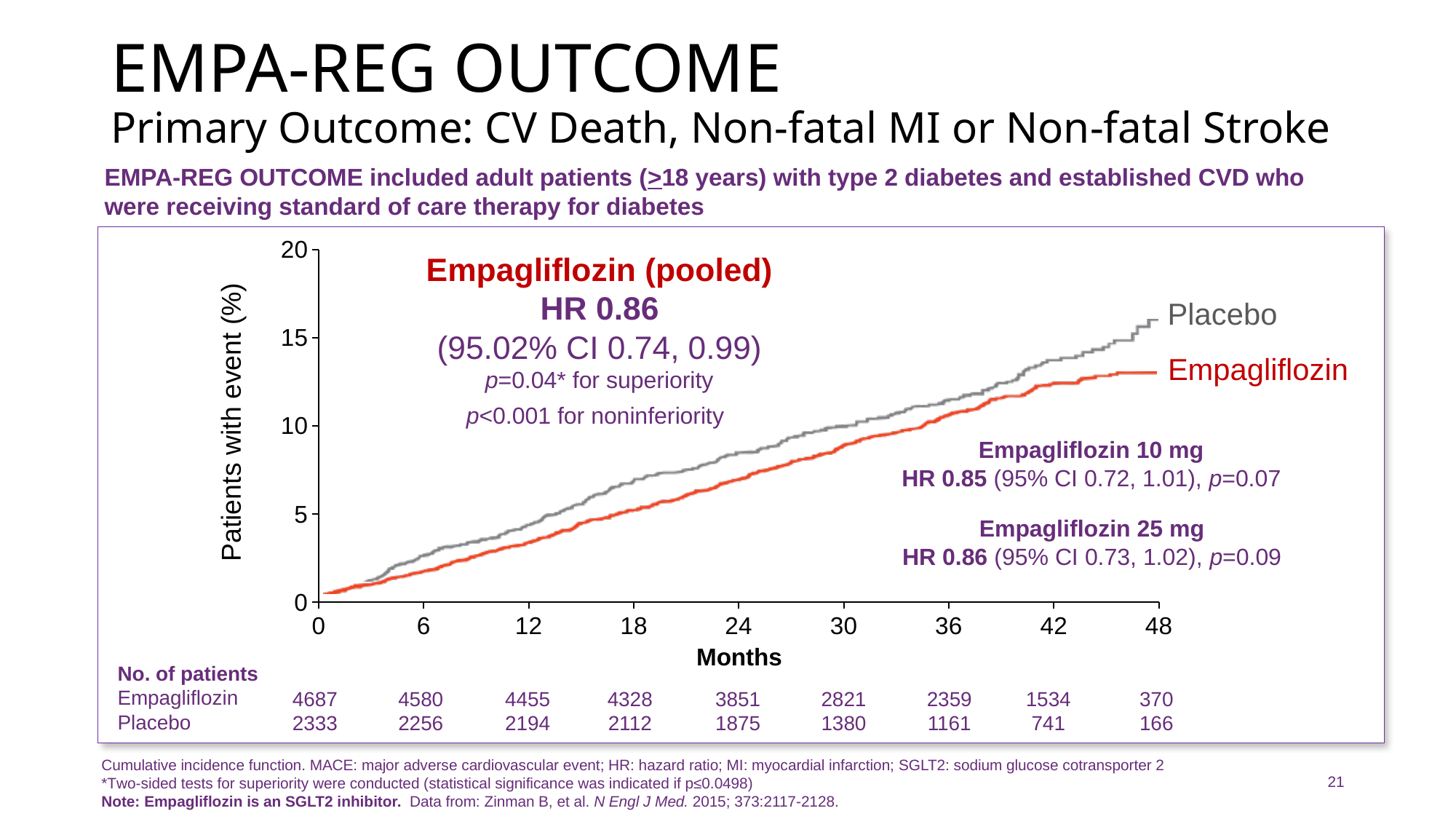
According to the No. of patients table, how many Empagliflozin patients were there at month 0? 4687 According to the No. of patients table, what is the difference between the number of Empagliflozin and Placebo patients at month 24? 1976 According to the No. of patients table, how many Placebo patients were there at month 48? 166 Is the value for Empagliflozin at 24 months greater or less than 10? less What is the label of the y axis of the chart? Patients with event (%) Is the value for Placebo at 48 months greater or less than 15? greater How many treatment groups (series) are plotted on the chart? 2 At 48 months, which group has the higher percentage of patients with an event, Placebo or Empagliflozin? Placebo What kind of chart is shown on the slide? Line chart What hazard ratio is reported for Empagliflozin (pooled) on the chart? HR 0.86 Is the value for Empagliflozin at 48 months greater or less than 15? less Do the curves rise or fall as months increase along the x axis? Rise